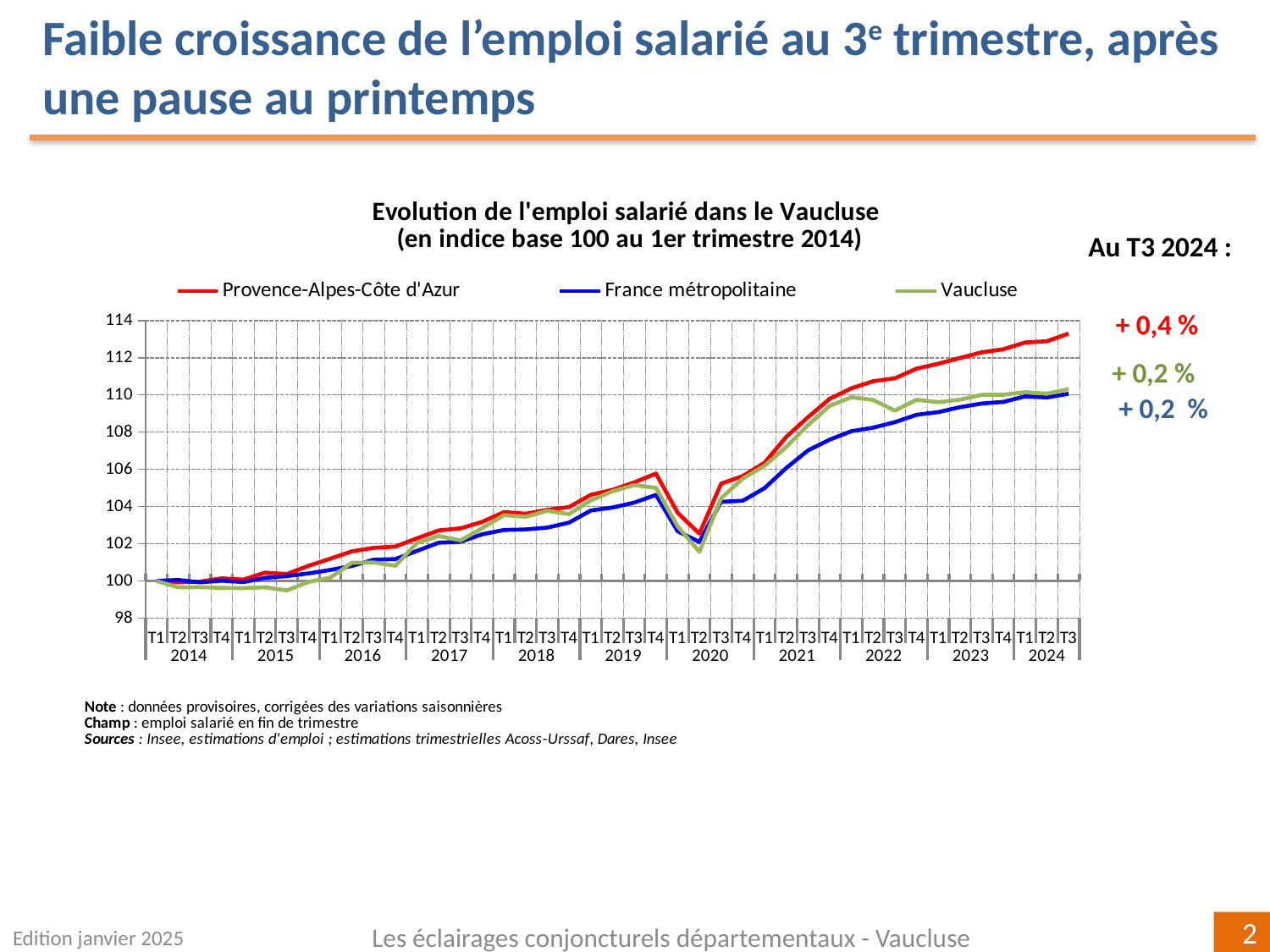
What kind of chart is shown on the slide? line chart How many years are labelled on the x axis? 11 Which series has the highest index value at T3 2024? Provence-Alpes-Côte d'Azur According to the annotation at T3 2024, what is the change for Vaucluse? + 0,2 % What is the title of the chart? Evolution de l'emploi salarié dans le Vaucluse (en indice base 100 au 1er trimestre 2014) Overall, do the index values rise or fall from 2014 to 2024? rise Is the value for France métropolitaine at T1 2021 greater or less than 106? less How many series does the legend list? 3 Is the value for Provence-Alpes-Côte d'Azur at T3 2024 greater or less than 112? greater According to the annotation at T3 2024, what is the change for Provence-Alpes-Côte d'Azur? + 0,4 % Is the value for Vaucluse at T2 2020 greater or less than 104? less Which series is drawn in red in the chart? Provence-Alpes-Côte d'Azur